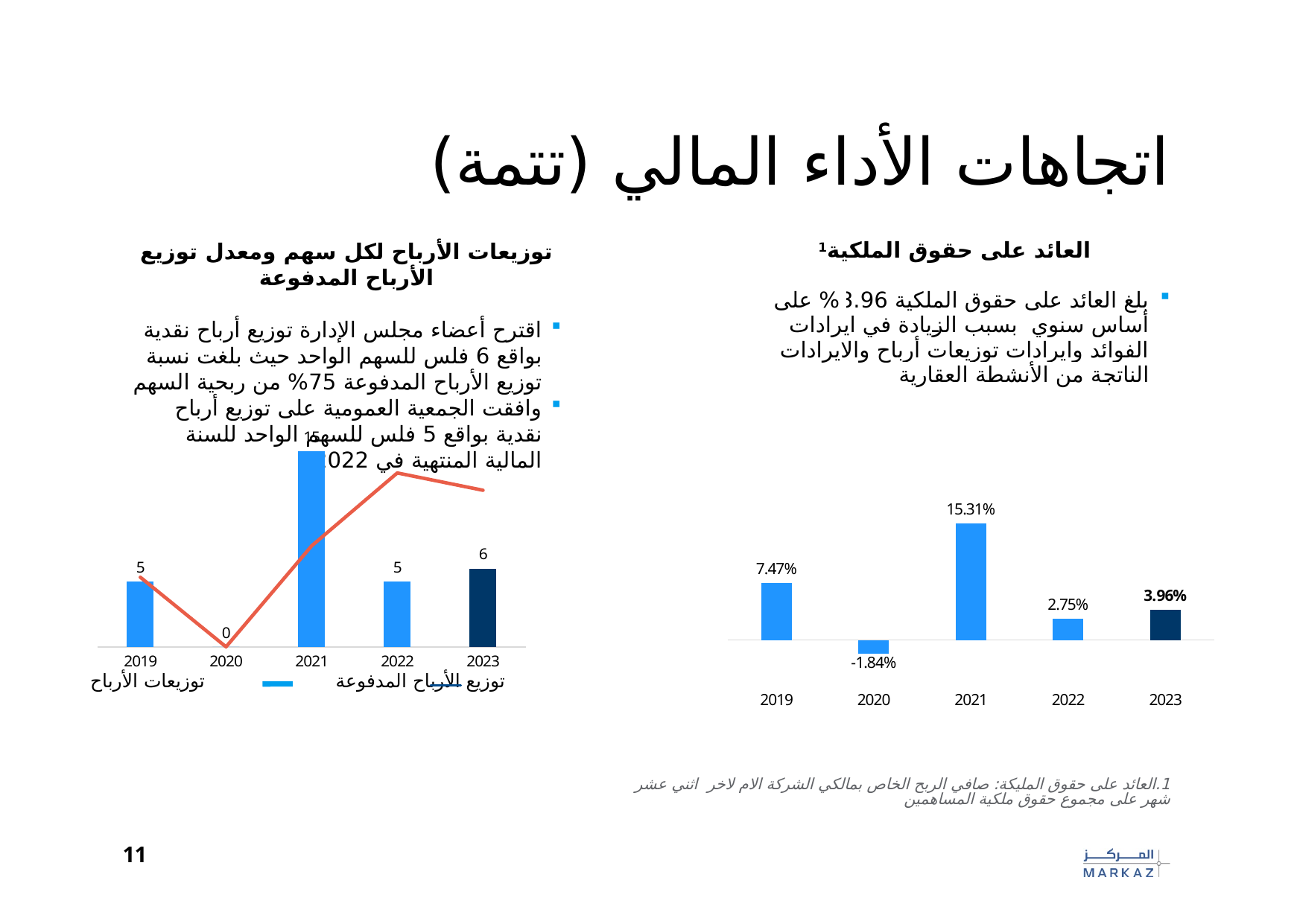
How many years are shown on the x axis of the right-hand chart (العائد على حقوق الملكية)? 5 How many series does the legend of the left-hand chart (توزيعات الأرباح لكل سهم) list? 2 In the right-hand chart (العائد على حقوق الملكية), which year has the lowest value? 2020 In the right-hand chart (العائد على حقوق الملكية), which year has the highest value? 2021 What kind of chart is the right-hand chart (العائد على حقوق الملكية)? Bar chart In the right-hand chart (العائد على حقوق الملكية), what is the difference between the 2019 value and the 2023 value? 3.51% In the left-hand chart (توزيعات الأرباح لكل سهم), what is the bar value for 2023? 6 In the right-hand chart (العائد على حقوق الملكية), what is the value for 2020? -1.84% In the left-hand chart (توزيعات الأرباح لكل سهم), what is the bar value for 2020? 0 In the right-hand chart (العائد على حقوق الملكية), which is larger, the value for 2022 or the value for 2023? 2023 In the right-hand chart (العائد على حقوق الملكية), what is the value for 2021? 15.31% In the left-hand chart (توزيعات الأرباح لكل سهم), which year has the tallest bar? 2021